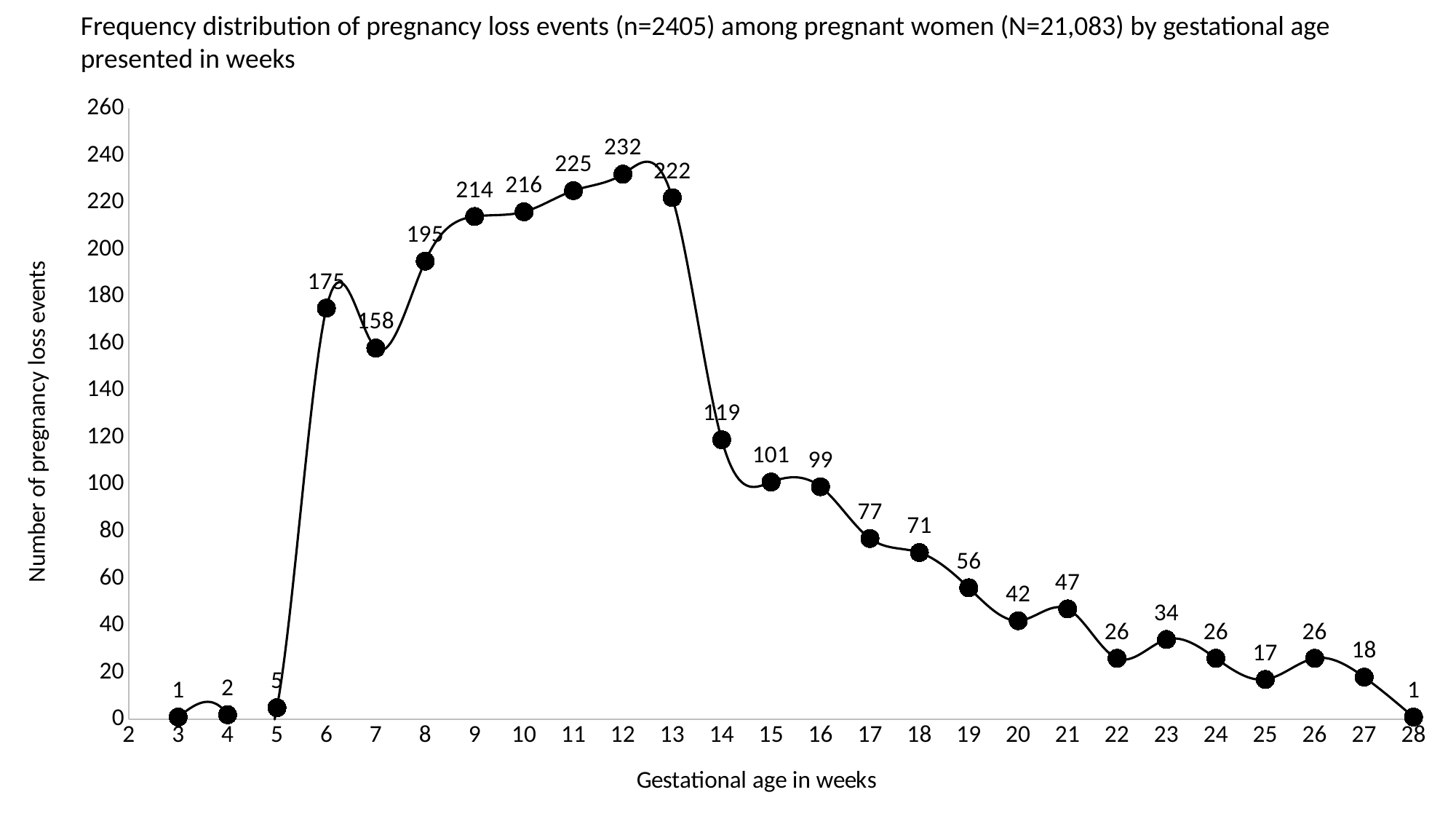
How many data points are plotted on the chart? 26 Do the number of pregnancy loss events rise or fall from week 13 to week 28? fall Is the number of pregnancy loss events at week 17 greater or less than 80? less How many pregnancy loss events are recorded at gestational week 20? 42 Which gestational week has more pregnancy loss events, week 14 or week 16? week 14 What type of chart is shown on the slide? line chart At which gestational week is the number of pregnancy loss events highest? 12 What is the difference between the number of pregnancy loss events at week 12 and at week 13? 10 What is the label of the y axis? Number of pregnancy loss events What is the difference between the number of pregnancy loss events at week 6 and at week 7? 17 How many pregnancy loss events are recorded at gestational week 7? 158 How many pregnancy loss events are recorded at gestational week 12? 232